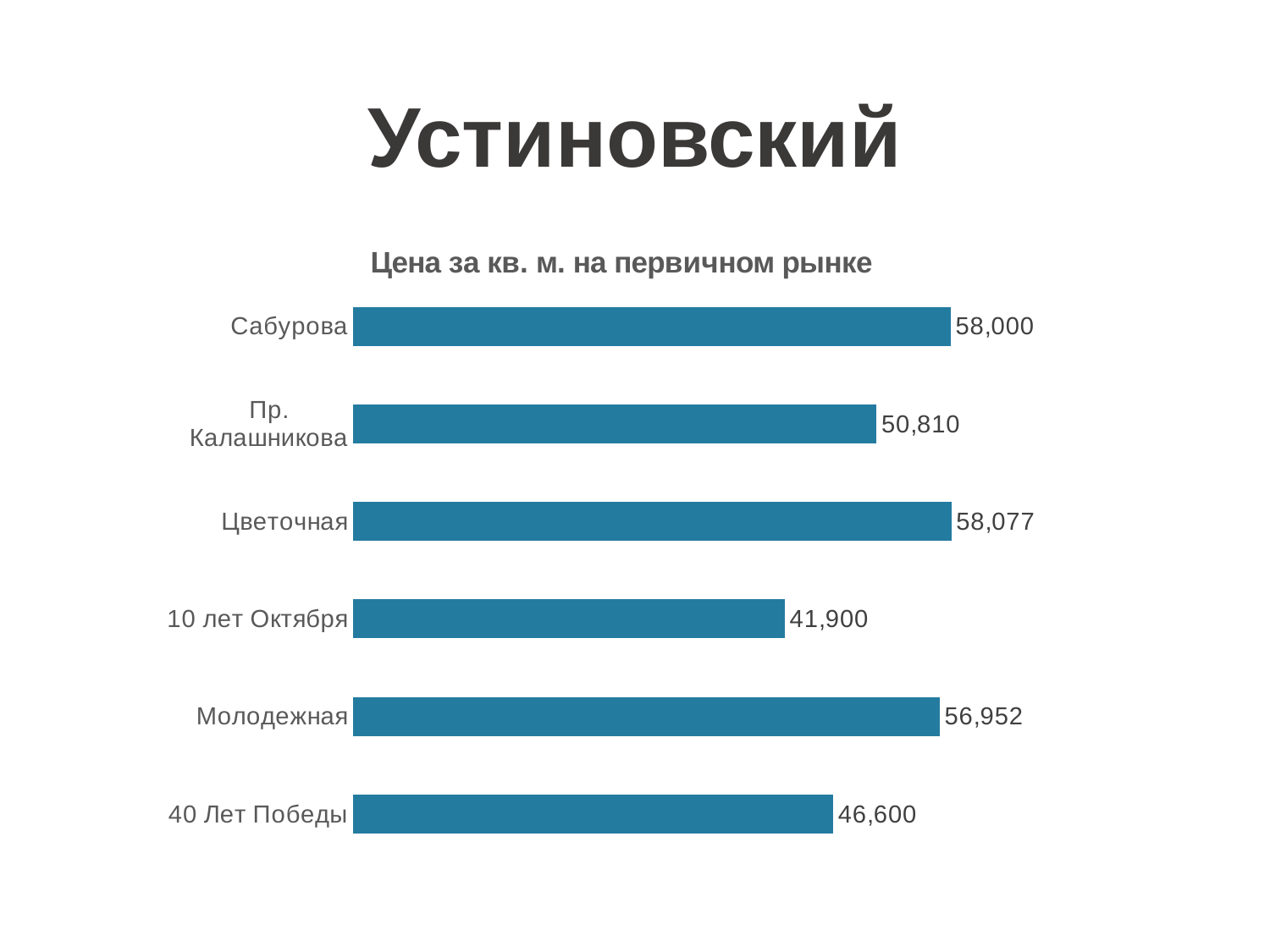
Which category has the lowest value? 10 лет Октября What is the difference between the values for Сабурова and Пр. Калашникова? 7,190 What is the value for 40 Лет Победы? 46,600 What is the value for 10 лет Октября? 41,900 What is the value for Сабурова? 58,000 What kind of chart is shown on the slide? Bar chart How many categories are shown in the chart? 6 Which category has the highest value? Цветочная What is the value for Пр. Калашникова? 50,810 What is the title of the chart? Цена за кв. м. на первичном рынке Which is larger, the value for Молодежная or the value for 40 Лет Победы? Молодежная What is the difference between the values for Молодежная and 40 Лет Победы? 10,352